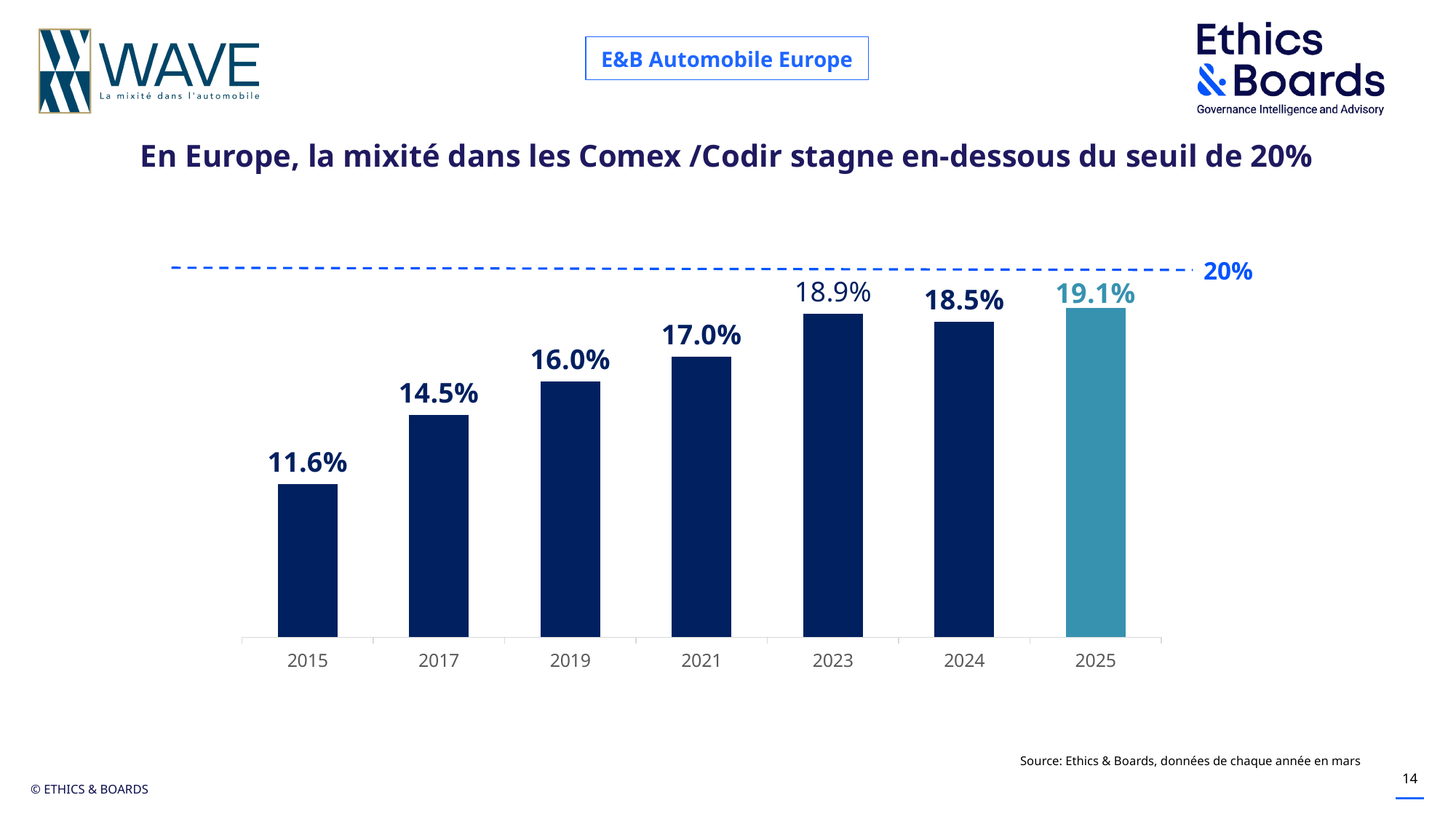
What is the value for 2025? 19.1% What is the value for 2015? 11.6% Is the value for 2025 greater or less than 20%? less What kind of chart is shown on the slide? bar chart What is the value for 2021? 17.0% How many years are shown on the x axis? 7 What value does the dashed horizontal line mark? 20% What is the difference between the values for 2025 and 2015? 7.5% Which is larger, the value for 2017 or the value for 2019? 2019 What is the difference between the values for 2023 and 2024? 0.4% Which year has the lowest value? 2015 Which year has the highest value? 2025